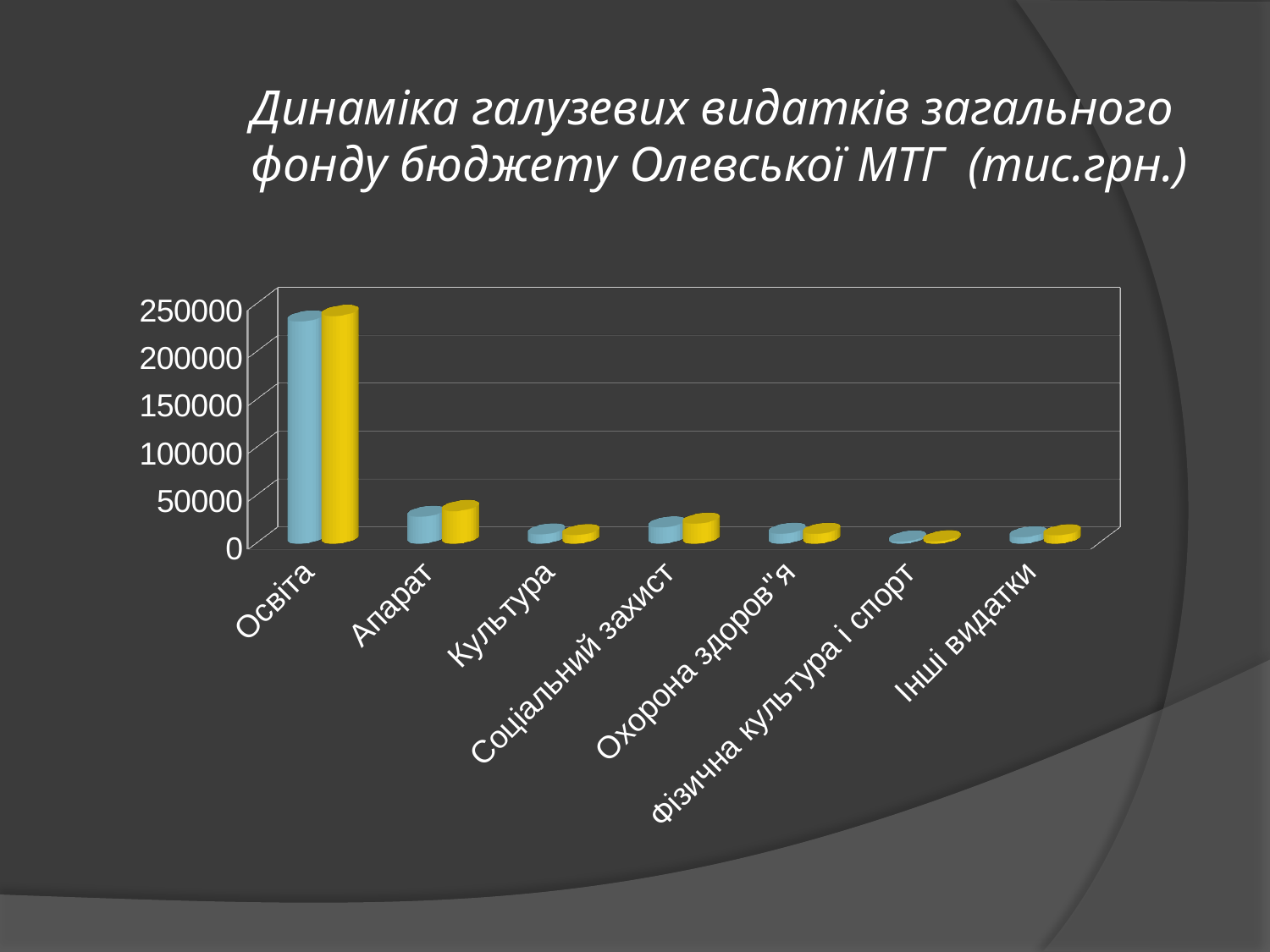
Is the yellow bar for Освіта greater or less than 200000? greater Which category has the lowest values in the chart? Фізична культура і спорт Which category has larger values, Апарат or Культура? Апарат What kind of chart is shown on the slide? bar chart Which category has larger values, Освіта or Апарат? Освіта How many categories are shown on the x axis of the chart? 7 Is the blue bar for Освіта greater or less than 200000? greater What unit is given in the chart title? тис.грн. Is the blue bar for Апарат greater or less than 50000? less What is the maximum value shown on the vertical axis of the chart? 250000 Which category has the highest values in the chart? Освіта